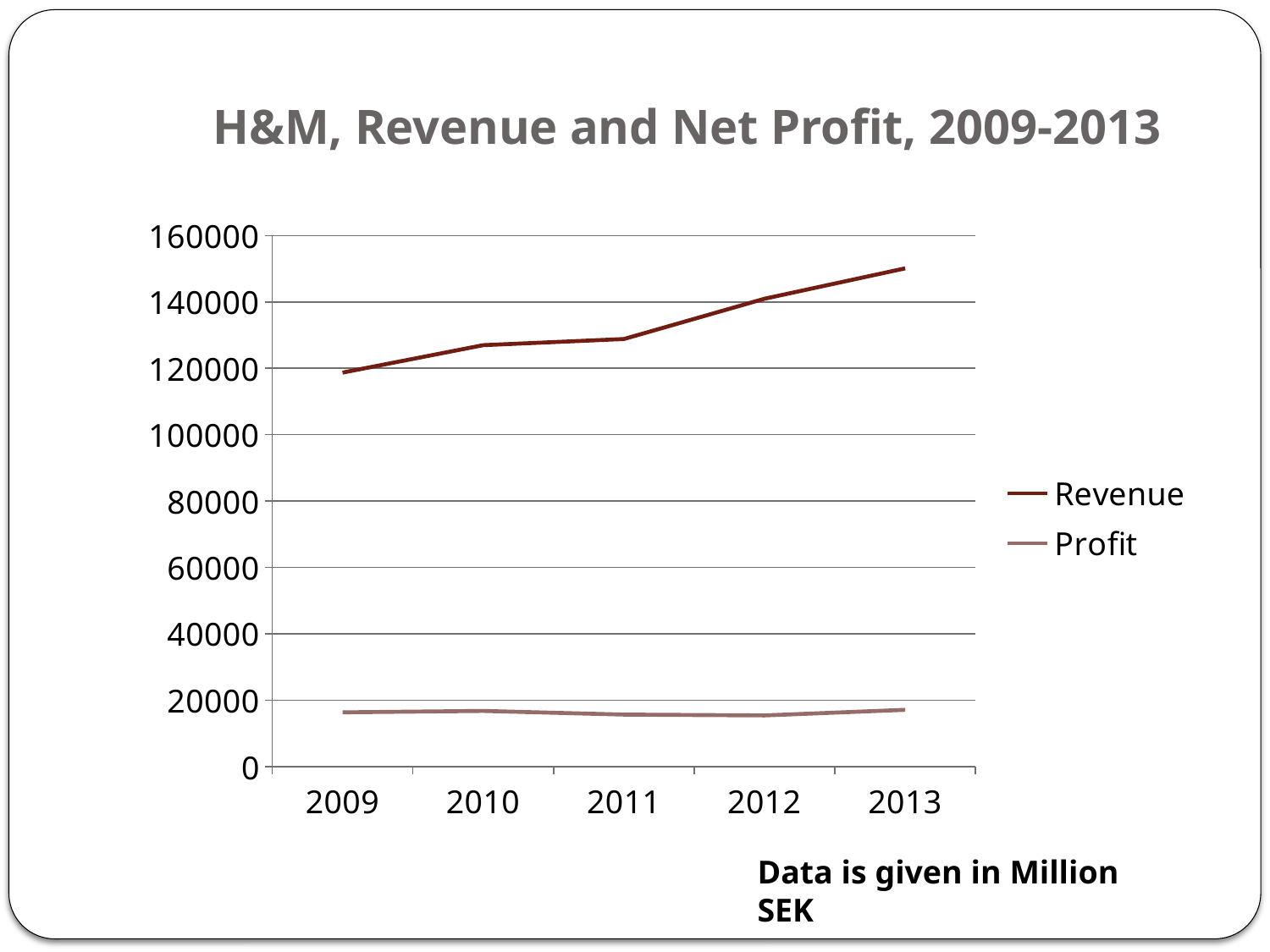
Is the Revenue value for 2011 greater or less than 140000? less Is the Revenue value for 2013 greater or less than 140000? greater How many series does the legend list? 2 What is the title of the chart? H&M, Revenue and Net Profit, 2009-2013 In which year is Revenue highest? 2013 Is the Profit value for 2013 greater or less than 20000? less How many years are plotted along the x axis? 5 In 2013, which is larger, Revenue or Profit? Revenue In which year is Revenue lowest? 2009 Does Revenue rise or fall from 2009 to 2013? rise What kind of chart is shown on the slide? line chart